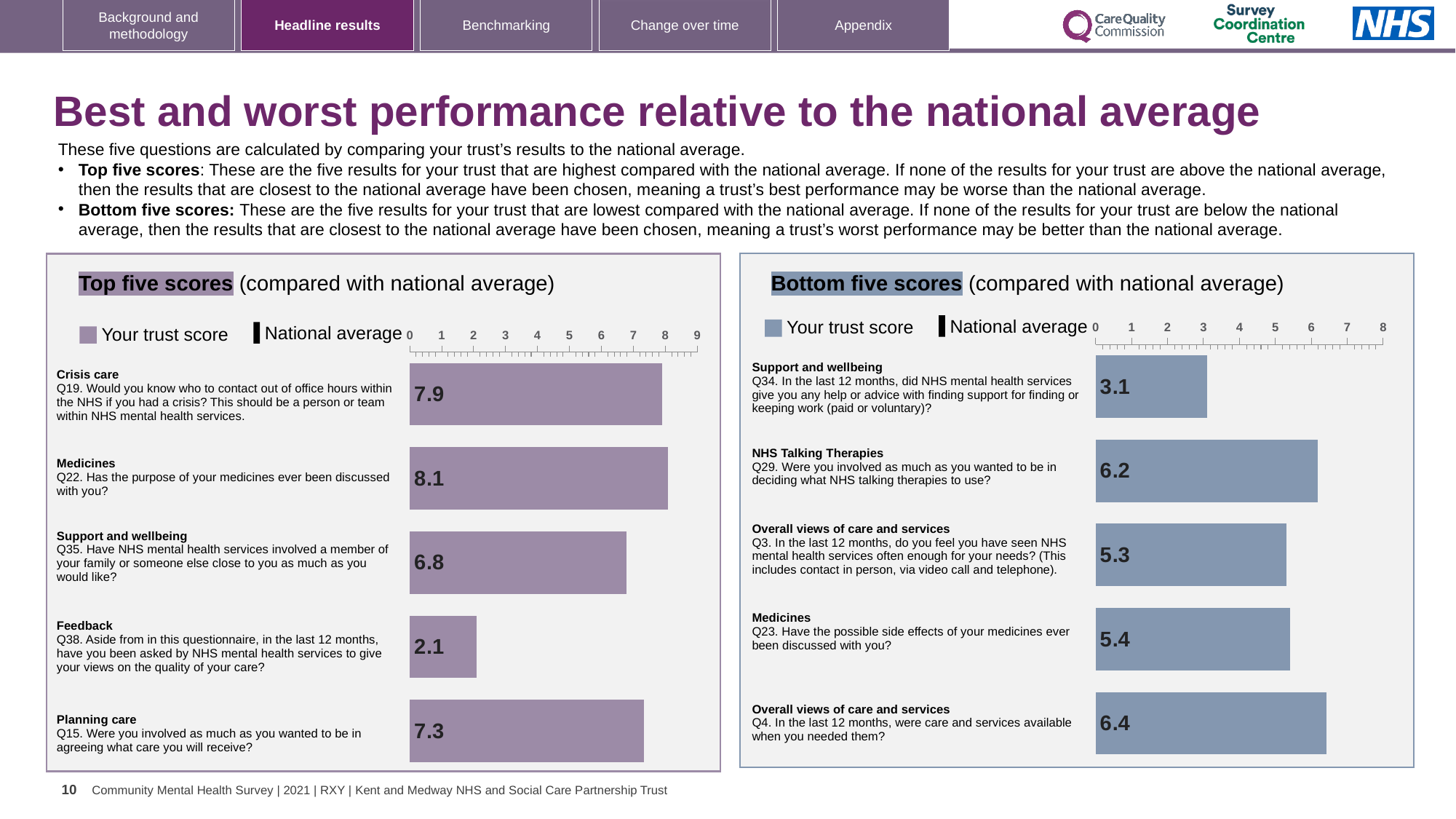
In the 'Bottom five scores' chart, which is larger: the trust score for Medicines (Q23) or for Support and wellbeing (Q34)? Medicines (Q23) In the 'Top five scores' chart, which question has the lowest trust score? Feedback (Q38) In the 'Top five scores' chart, what is the difference between the trust scores for Medicines (Q22) and Planning care (Q15)? 0.8 In the 'Top five scores' chart, what is the trust score for Crisis care (Q19)? 7.9 In the 'Bottom five scores' chart, what is the difference between the trust scores for Q4 and Q34? 3.3 In the 'Top five scores' chart, which question has the highest trust score? Medicines (Q22) In the 'Bottom five scores' chart, what is the trust score for Support and wellbeing (Q34)? 3.1 In the 'Top five scores' chart, what is the trust score for Feedback (Q38)? 2.1 In the 'Bottom five scores' chart, what is the trust score for NHS Talking Therapies (Q29)? 6.2 In the 'Top five scores' chart, how many questions are plotted? 5 What type of chart is used in the 'Top five scores' panel? Bar chart In the 'Bottom five scores' chart, which question has the highest trust score? Overall views of care and services (Q4)